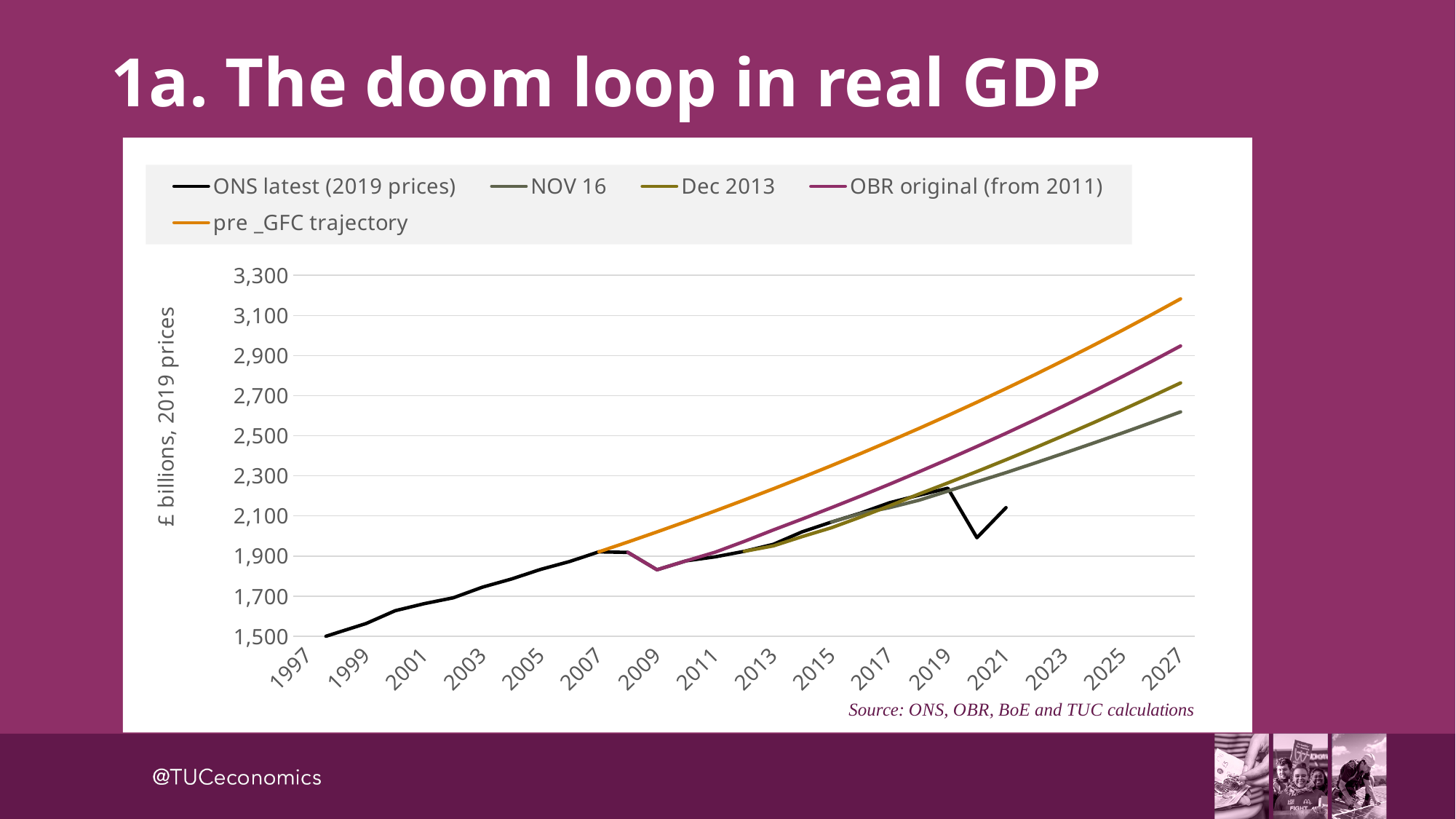
Which series has the highest value in 2027? pre _GFC trajectory Is the value for OBR original (from 2011) in 2027 greater or less than 2,700? greater How many year labels are shown on the x axis? 16 What kind of chart is shown on the slide? Line chart Is the lowest value of ONS latest (2019 prices) after 2019 greater or less than 2,100? less Which series has the lowest value in 2027? NOV 16 What is the label on the y axis? £ billions, 2019 prices How many series does the legend list? 5 Does the pre _GFC trajectory line rise or fall from 2007 to 2027? Rises Is the value for NOV 16 in 2027 greater or less than 2,700? less In 2027, which is larger: OBR original (from 2011) or Dec 2013? OBR original (from 2011)